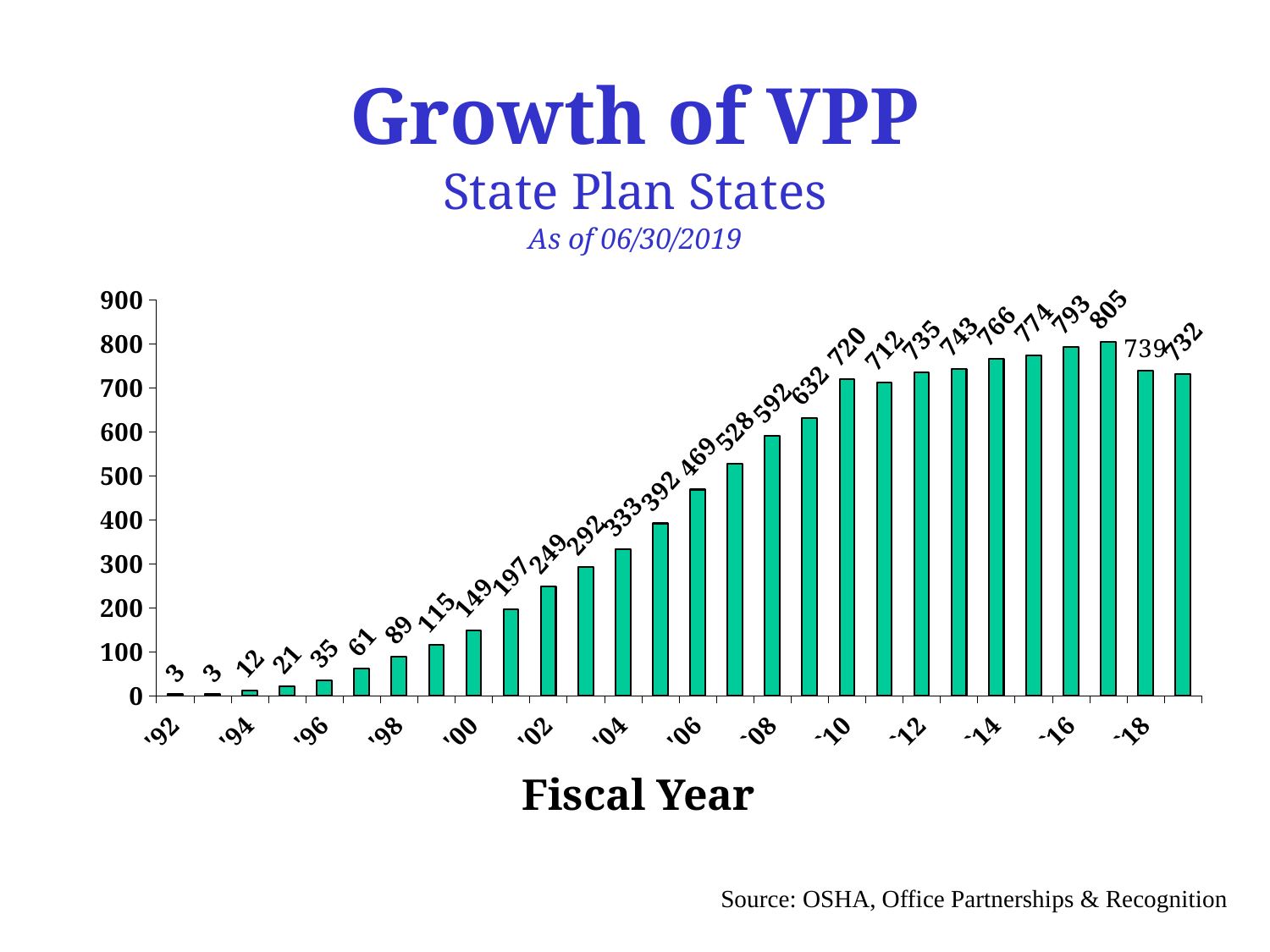
What is the value for fiscal year '00? 149 Which fiscal year has the larger value, '10 or '12? '12 Is the value for fiscal year '08 greater or less than 500? greater What is the highest value shown on the chart? 805 How many bars are plotted on the chart? 28 Do the values rise or fall from '92 to '10? rise What type of chart is shown on the slide? bar chart What is the value for fiscal year '10? 720 What is the value for fiscal year '06? 469 What is the difference between the values for '16 and '14? 27 What is the lowest value shown on the chart? 3 What is the value for fiscal year '18? 739